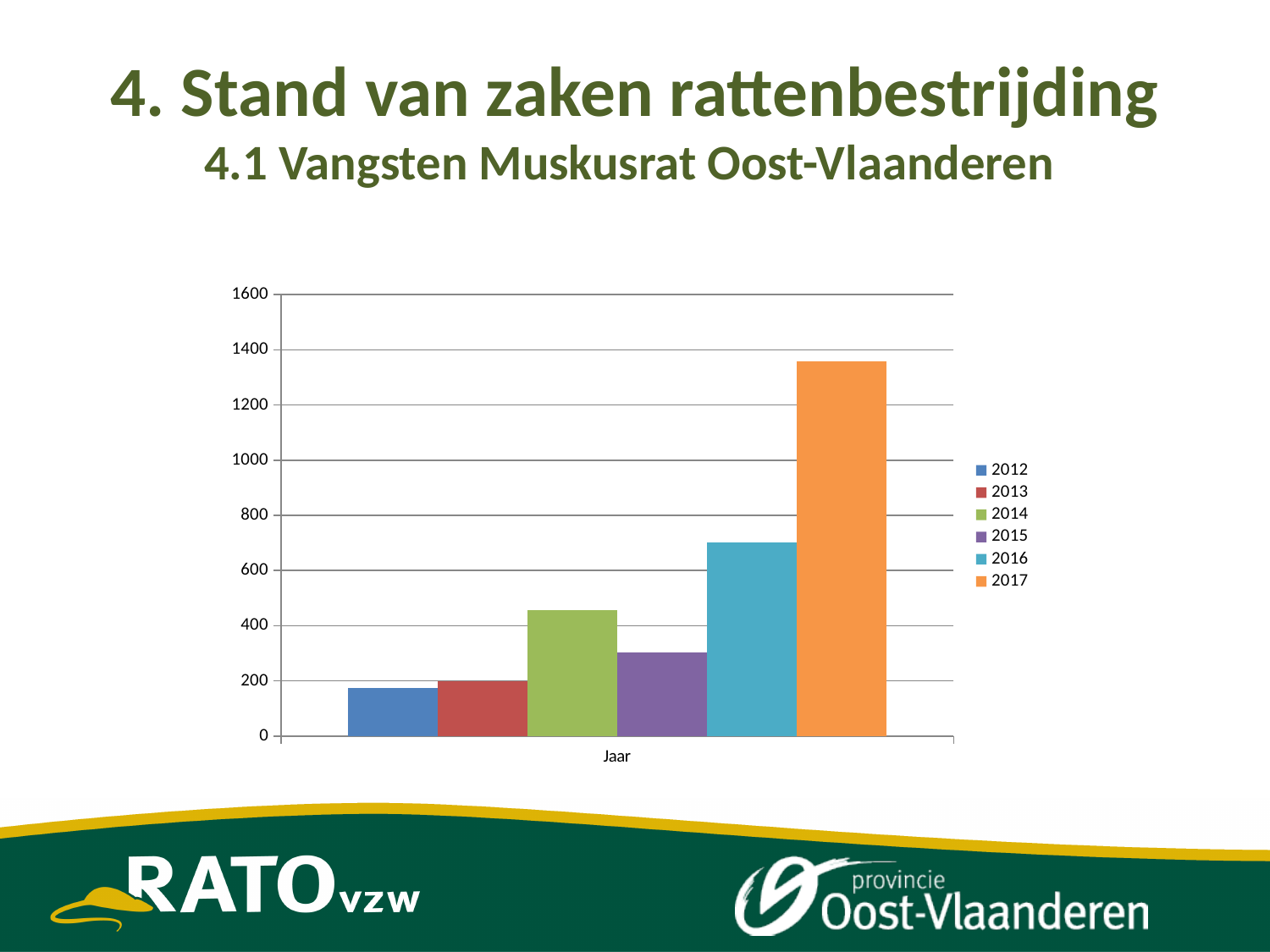
What is the title of the horizontal axis? Jaar Is the value for 2017 greater or less than 1200? greater What kind of chart is shown on the slide? bar chart Is the value for 2015 greater or less than 400? less Which is larger, the value for 2016 or the value for 2017? 2017 Is the value for 2014 greater or less than 400? greater Which year has the highest value in the chart? 2017 Which is larger, the value for 2014 or the value for 2015? 2014 Which year has the lowest value in the chart? 2012 How many series does the legend list? 6